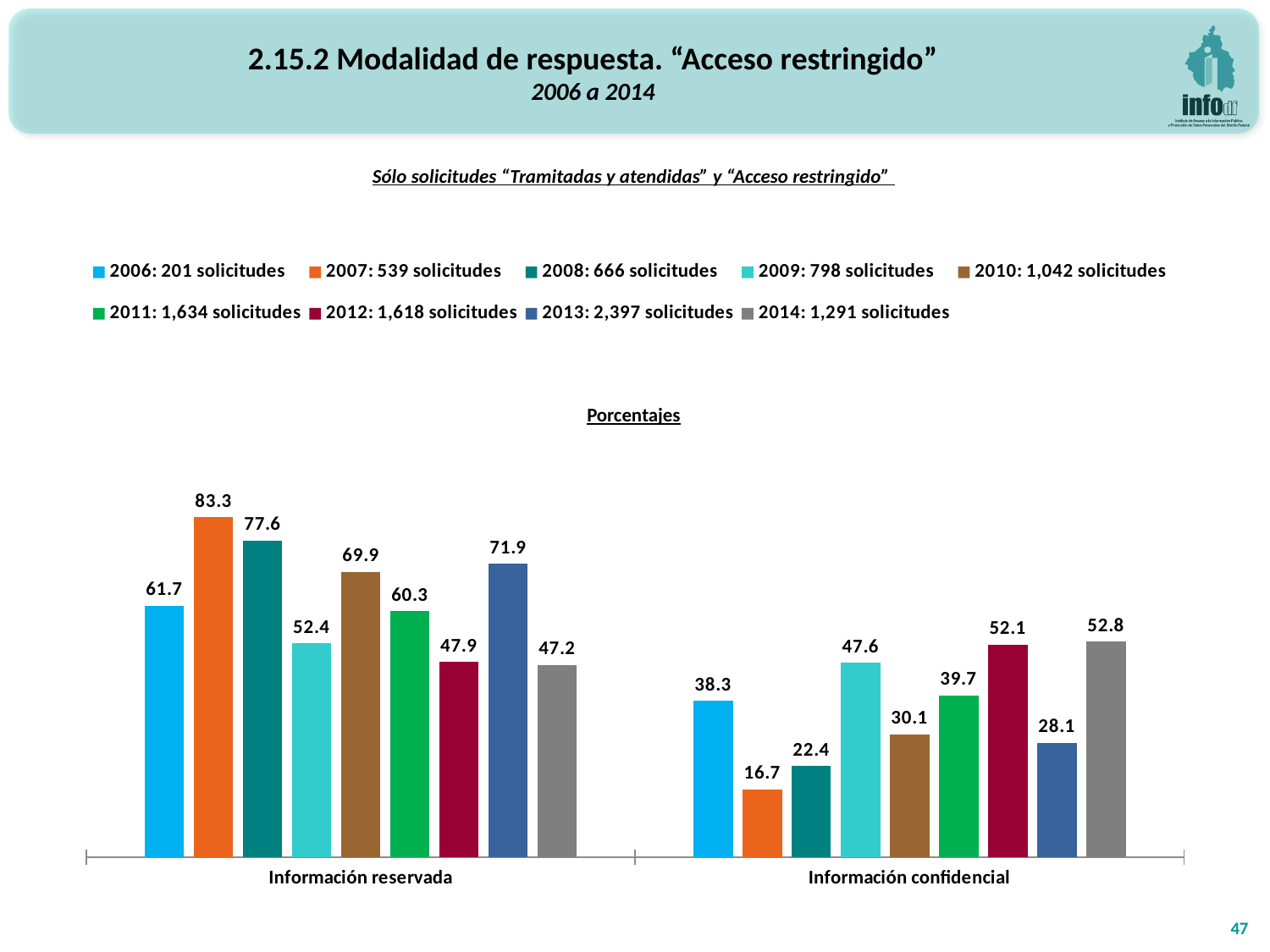
Which year has the lowest value in the "Información reservada" category? 2014 Which year has the highest value in the "Información reservada" category? 2007 What is the difference between the 2006 values for "Información reservada" and "Información confidencial"? 23.4 What is the value for 2010 in the "Información reservada" category? 69.9 According to the legend, how many solicitudes were there in 2013? 2,397 How many series does the legend list? 9 What kind of chart is shown on the slide? Bar chart Which year has the lowest value in the "Información confidencial" category? 2007 Which is larger: the 2009 value for "Información confidencial" or the 2011 value for "Información confidencial"? 2009 What is the value for 2007 in the "Información reservada" category? 83.3 What is the value for 2013 in the "Información confidencial" category? 28.1 How many categories are shown on the x axis? 2